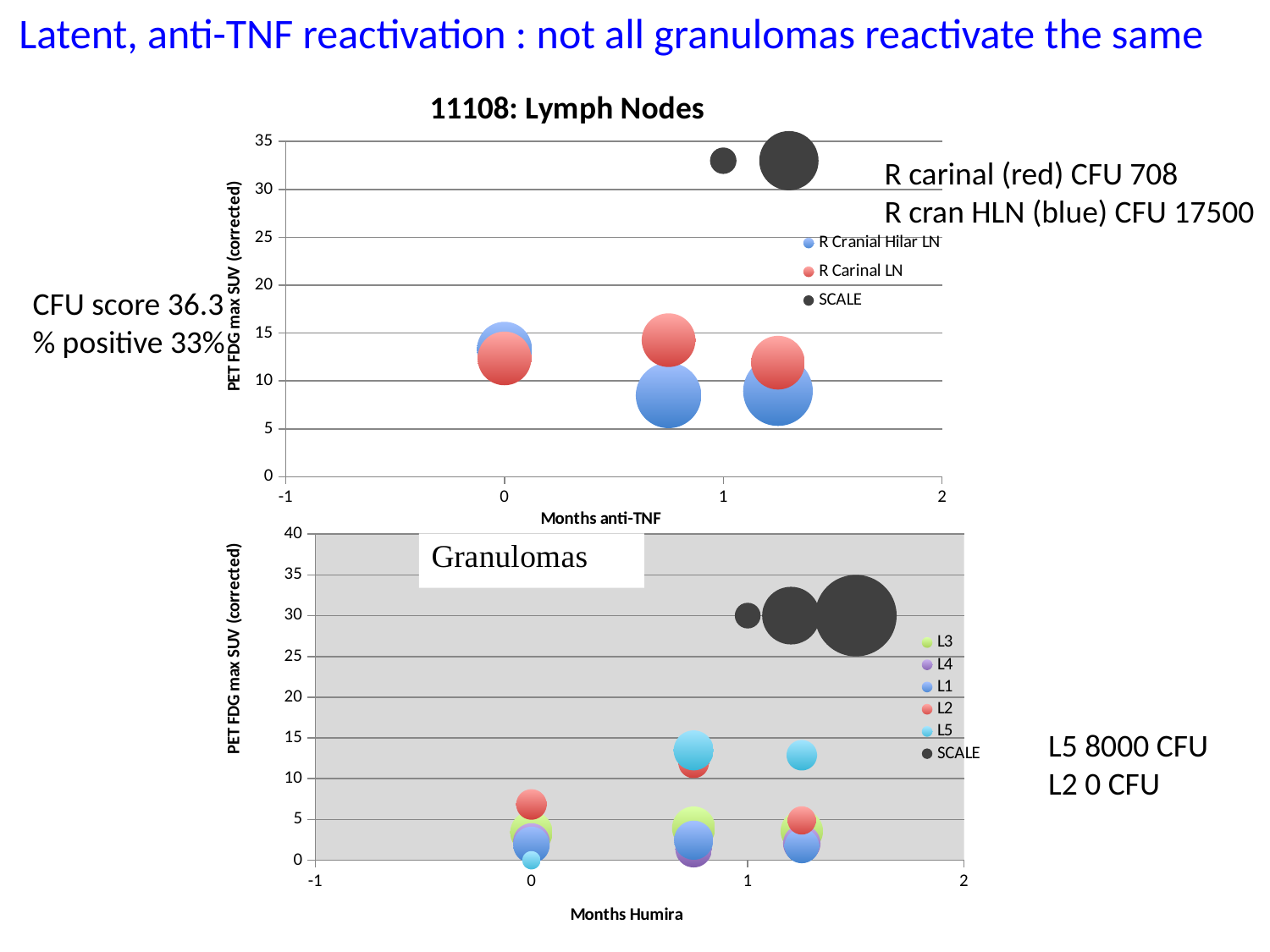
What is the x-axis title of the bottom chart "Granulomas"? Months Humira In the top chart "11108: Lymph Nodes", is the value for R Cranial Hilar LN at about month 0.75 greater or less than 10? less In the bottom chart "Granulomas", is the value for L5 at about month 0.75 greater or less than 10? greater In the top chart "11108: Lymph Nodes", at about month 0.75, which series has the higher PET FDG max SUV: R Carinal LN or R Cranial Hilar LN? R Carinal LN In the bottom chart "Granulomas", does the value for L5 rise or fall from month 0 to the later time points? rise How many series does the legend of the bottom chart "Granulomas" list? 6 In the top chart "11108: Lymph Nodes", does the value for R Cranial Hilar LN rise or fall from month 0 to the later time points? fall In the bottom chart "Granulomas", is the value for L1 at month 0 greater or less than 5? less In the bottom chart "Granulomas", at about month 0.75, which series has the higher PET FDG max SUV: L5 or L1? L5 How many series does the legend of the top chart "11108: Lymph Nodes" list? 3 What kind of chart is the top chart titled "11108: Lymph Nodes"? bubble chart